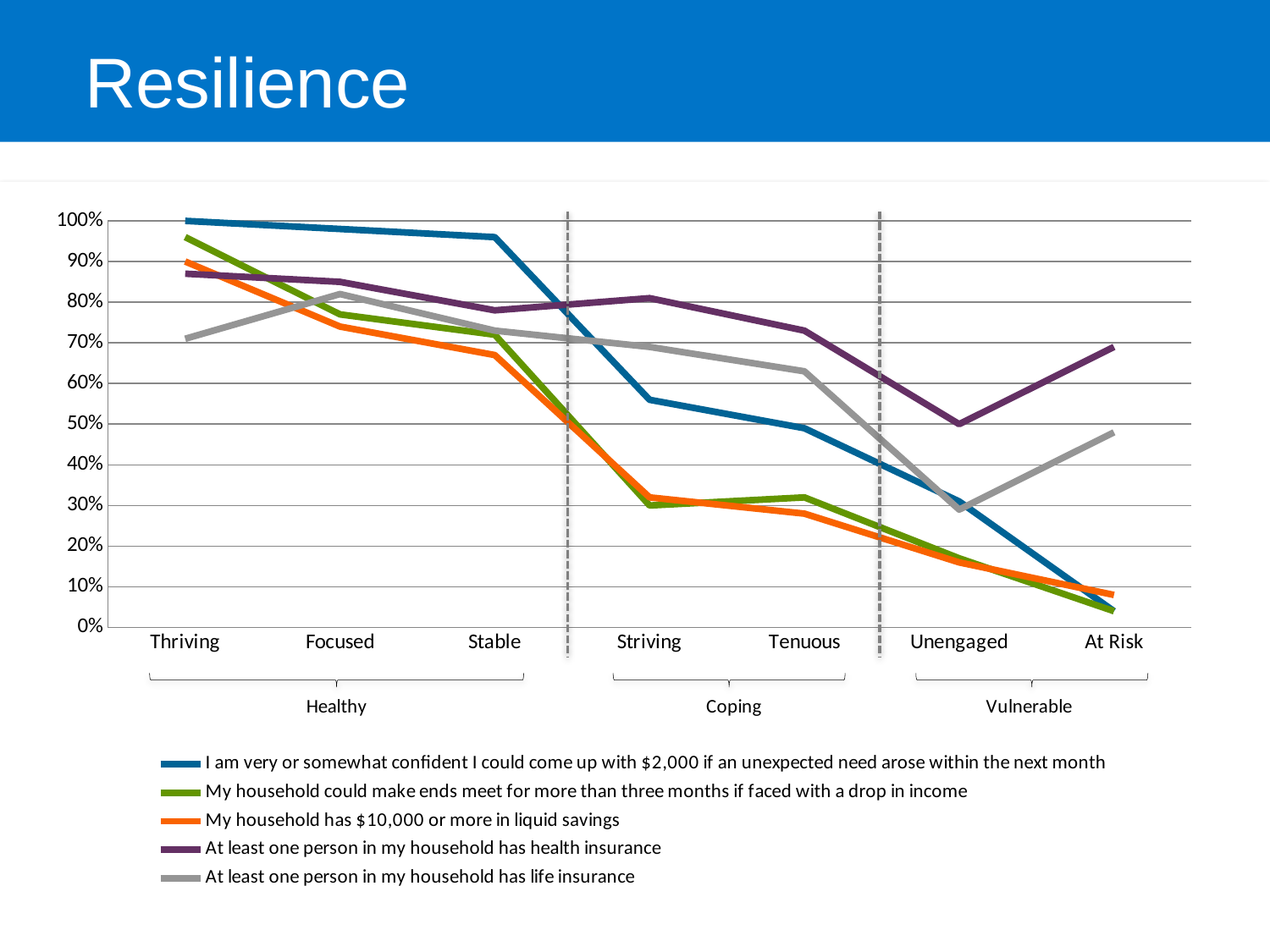
What kind of chart is shown on the slide? line chart What are the three group labels shown beneath the x-axis categories? Healthy, Coping, Vulnerable How many categories are shown along the x axis? 7 How many series does the legend list? 5 Which series has the lowest value at Thriving? At least one person in my household has life insurance Does the value for 'I am very or somewhat confident I could come up with $2,000 if an unexpected need arose within the next month' rise or fall from Thriving to At Risk? fall What is the value for 'I am very or somewhat confident I could come up with $2,000 if an unexpected need arose within the next month' at Thriving? 100% Is the value for 'My household could make ends meet for more than three months if faced with a drop in income' at At Risk greater or less than 10%? less Is the value for 'I am very or somewhat confident I could come up with $2,000 if an unexpected need arose within the next month' at Striving greater or less than 50%? greater At Striving, which is larger: the value for 'At least one person in my household has health insurance' or the value for 'I am very or somewhat confident I could come up with $2,000 if an unexpected need arose within the next month'? At least one person in my household has health insurance Which series has the highest value at At Risk? At least one person in my household has health insurance Which series has the highest value at Unengaged? At least one person in my household has health insurance